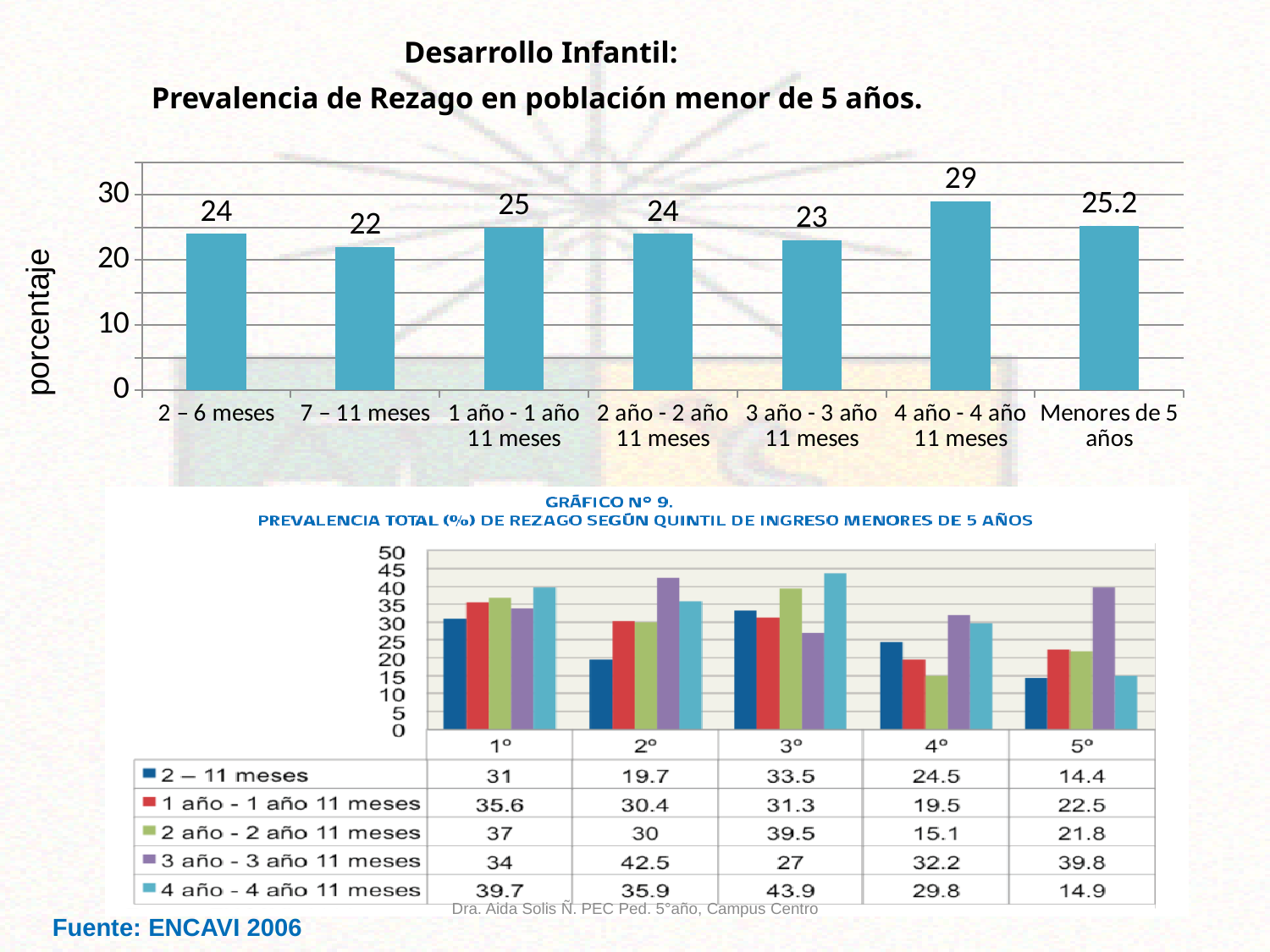
In the bottom chart (Gráfico N° 9), which series has the highest value in quintile 3°? 4 año - 4 año 11 meses In the top chart, how many categories are shown on the x axis? 7 In the bottom chart (Gráfico N° 9), what is the value for 2 – 11 meses in quintile 3°? 33.5 In the bottom chart (Gráfico N° 9), what is the value for 3 año - 3 año 11 meses in quintile 2°? 42.5 In the top chart, what is the value for Menores de 5 años? 25.2 In the top chart, what is the value for 4 año - 4 año 11 meses? 29 What kind of chart is the top chart? bar chart In the top chart, what is the difference between the values for 4 año - 4 año 11 meses and 7 – 11 meses? 7 In the bottom chart (Gráfico N° 9), how many series does the legend list? 5 In the bottom chart (Gráfico N° 9), which is larger in quintile 5°: 2 – 11 meses or 3 año - 3 año 11 meses? 3 año - 3 año 11 meses In the top chart, which category has the highest value? 4 año - 4 año 11 meses In the top chart, which category has the lowest value? 7 – 11 meses